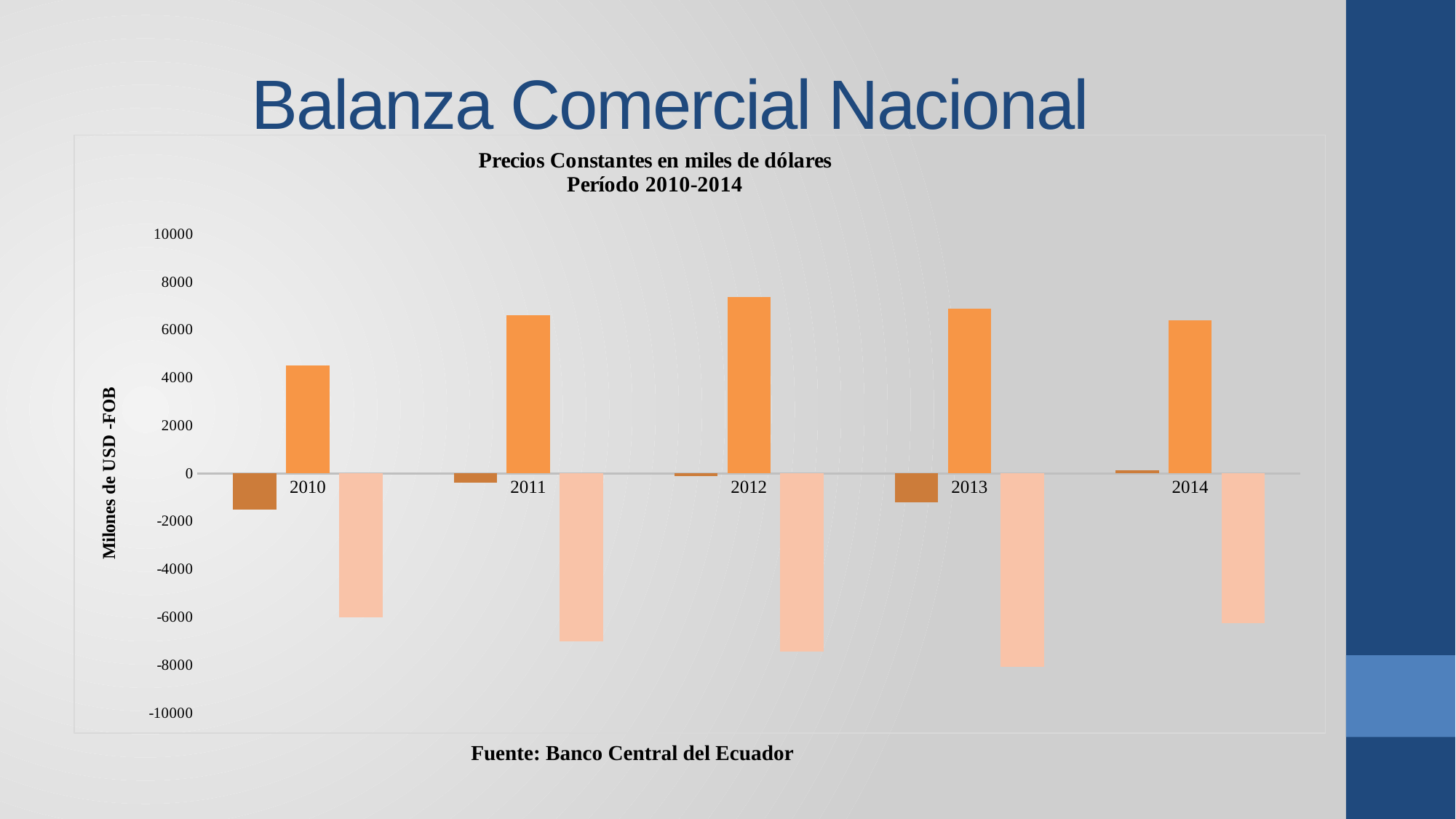
Is the value of the light orange bar for 2011 greater or less than -6000? less Is the value of the middle (orange) bar for 2012 greater or less than 6000? greater Do the middle (orange) bars rise or fall from 2010 to 2012? rise What kind of chart is shown on the slide? bar chart Is the value of the middle (orange) bar for 2010 greater or less than 4000? greater In which year does the dark orange bar reach the lowest (most negative) value? 2010 Which year has the larger middle (orange) bar, 2010 or 2011? 2011 How many years are shown on the x axis of the chart? 5 What is the title of the vertical axis of the chart? Milones de USD -FOB In which year is the middle (orange) bar the tallest? 2012 In which year is the middle (orange) bar the shortest? 2010 In which year does the light orange bar reach the lowest (most negative) value? 2013